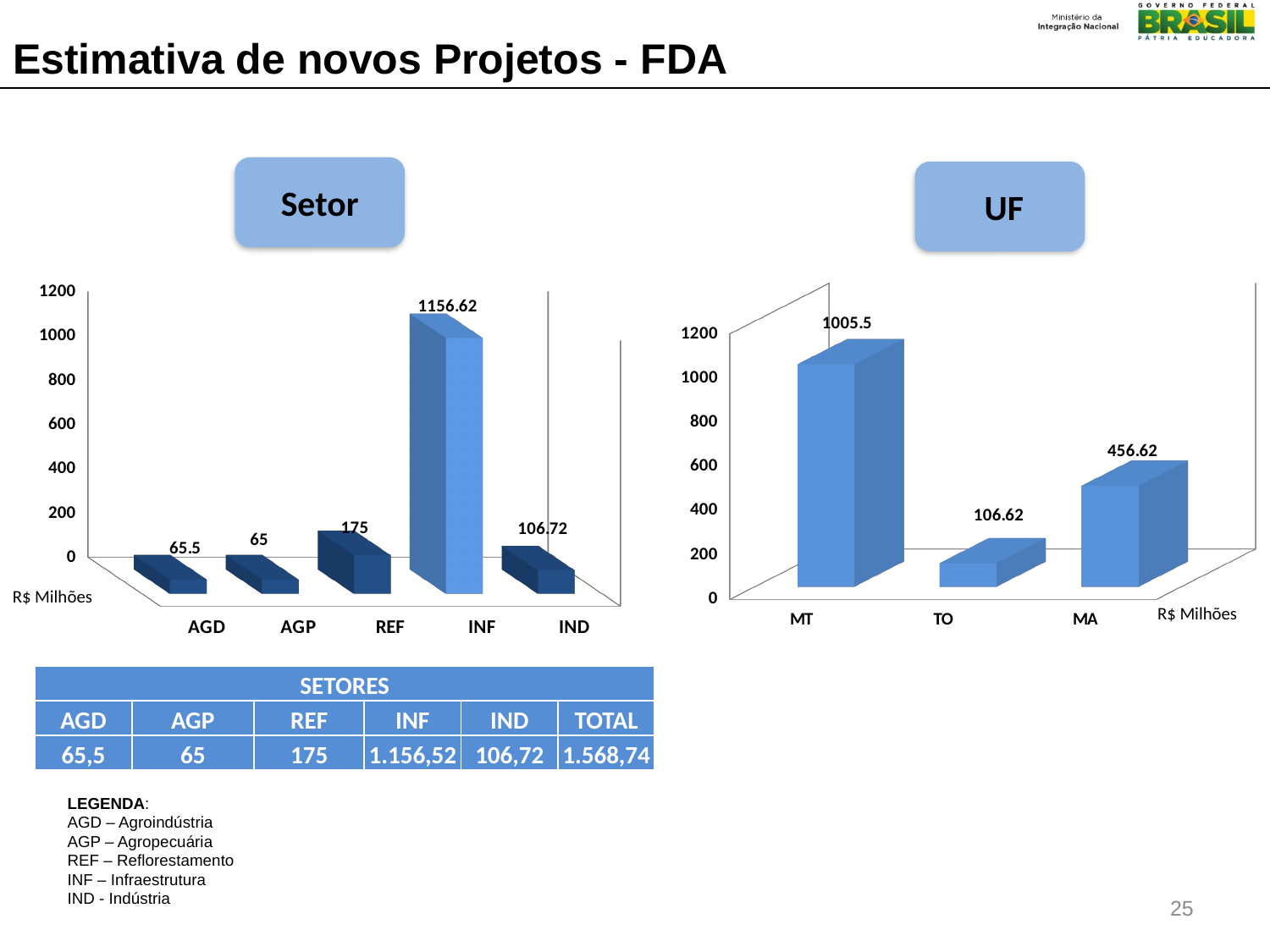
In the UF chart, what is the value for TO? 106.62 In the Setor chart, what is the value for INF? 1156.62 In the UF chart, what is the difference between the values for MA and TO? 350 In the Setor chart, what is the difference between the values for INF and REF? 981.62 What kind of chart is the UF chart? bar chart In the Setor chart, which is larger, the value for IND or the value for REF? REF In the Setor chart, what is the value for REF? 175 How many categories are shown in the Setor chart? 5 In the Setor chart, which category has the highest value? INF In the UF chart, what is the value for MT? 1005.5 In the UF chart, is the value for MA greater or less than 400? greater In the UF chart, which category has the lowest value? TO